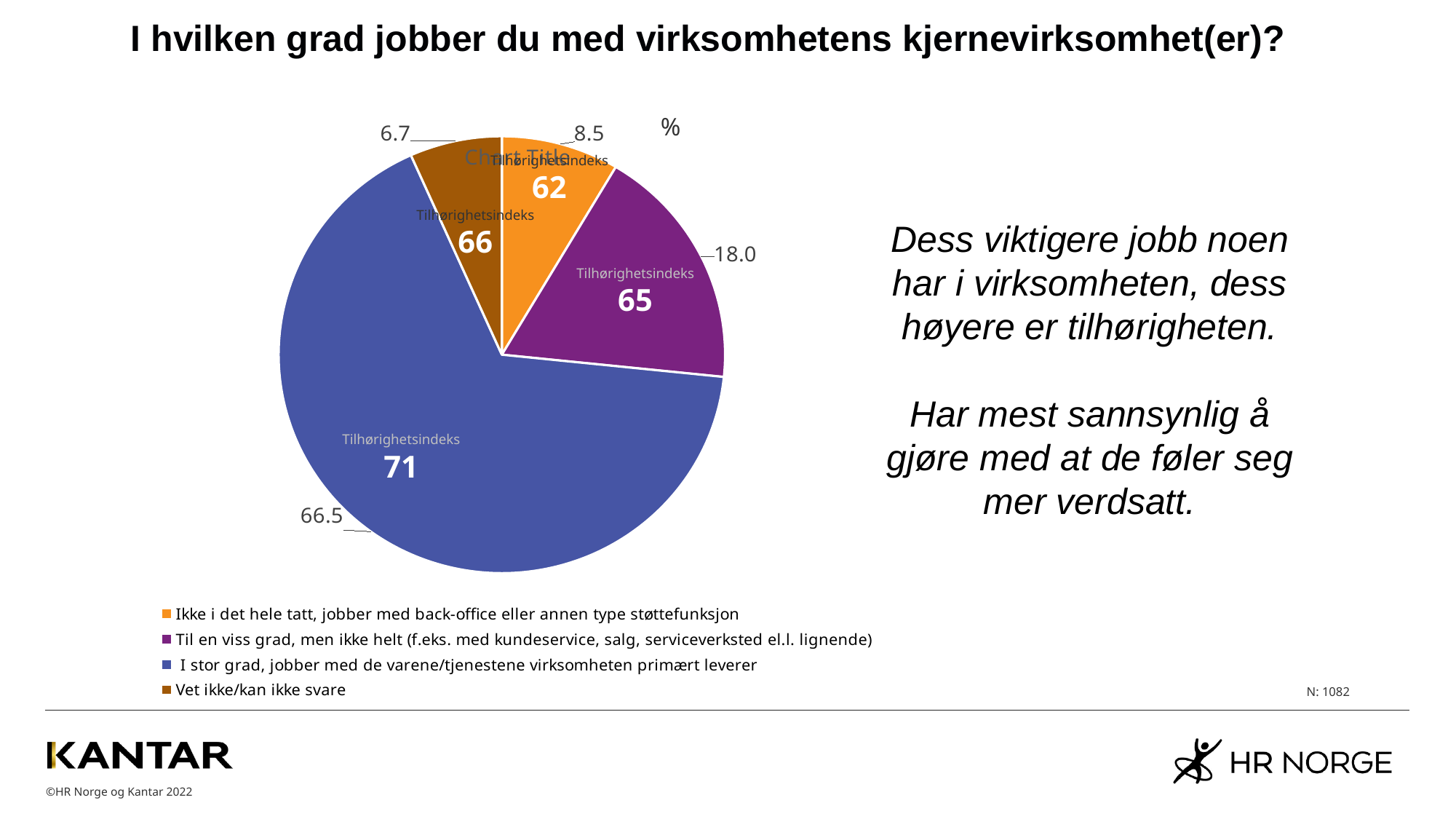
How many slices does the pie chart have? 4 What percentage share does the slice 'Til en viss grad, men ikke helt (f.eks. med kundeservice, salg, serviceverksted el.l. lignende)' have? 18.0 Which slice is larger: 'Til en viss grad' or 'Vet ikke/kan ikke svare'? Til en viss grad What is the Tilhørighetsindeks shown for the 'I stor grad' slice? 71 What kind of chart is shown on the slide? pie chart What percentage share does the slice 'I stor grad, jobber med de varene/tjenestene virksomheten primært leverer' have? 66.5 What is the Tilhørighetsindeks shown for the 'Ikke i det hele tatt' slice? 62 What is the difference in percentage share between the 'Til en viss grad' slice and the 'Ikke i det hele tatt' slice? 9.5 What percentage share does the slice 'Ikke i det hele tatt, jobber med back-office eller annen type støttefunksjon' have? 8.5 What percentage share does the slice 'Vet ikke/kan ikke svare' have? 6.7 Which category has the smallest slice of the pie? Vet ikke/kan ikke svare Which category has the largest slice of the pie? I stor grad, jobber med de varene/tjenestene virksomheten primært leverer